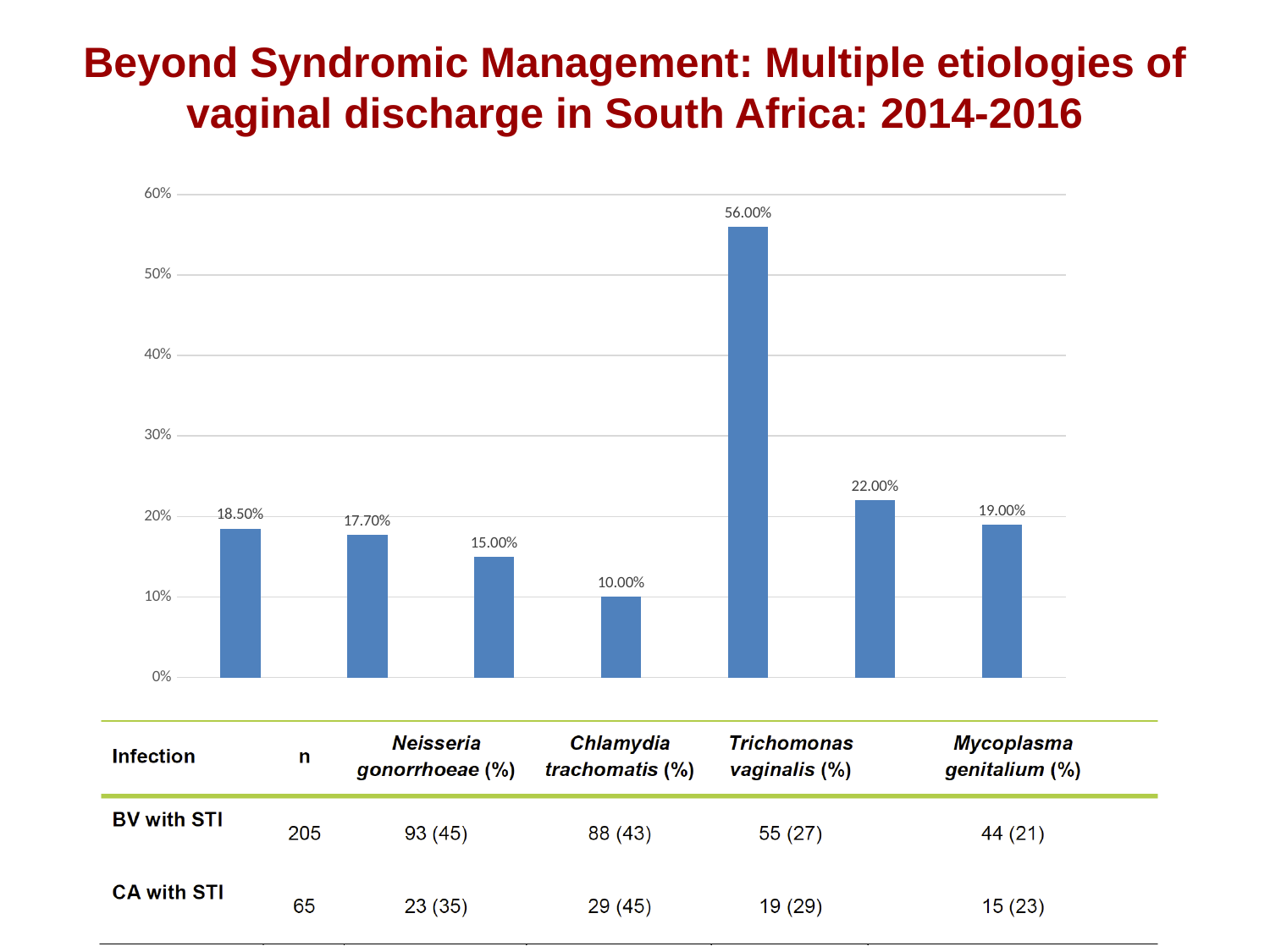
Which is larger, the sixth bar or the seventh bar? the sixth bar (22.00%) What is the difference between the first bar (18.50%) and the second bar (17.70%)? 0.80% What is the value of the last bar on the right? 19.00% What is the lowest value shown by a data label in the chart? 10.00% What is the highest tick value shown on the y axis? 60% What kind of chart is shown on the slide? bar chart Is the value of the tallest bar greater or less than 50%? greater How many bars are plotted in the chart? 7 What is the value of the first bar from the left? 18.50% What is the difference between the tallest bar (56.00%) and the sixth bar (22.00%)? 34.00% What is the highest value shown by a data label in the chart? 56.00% What is the value of the second bar from the left? 17.70%